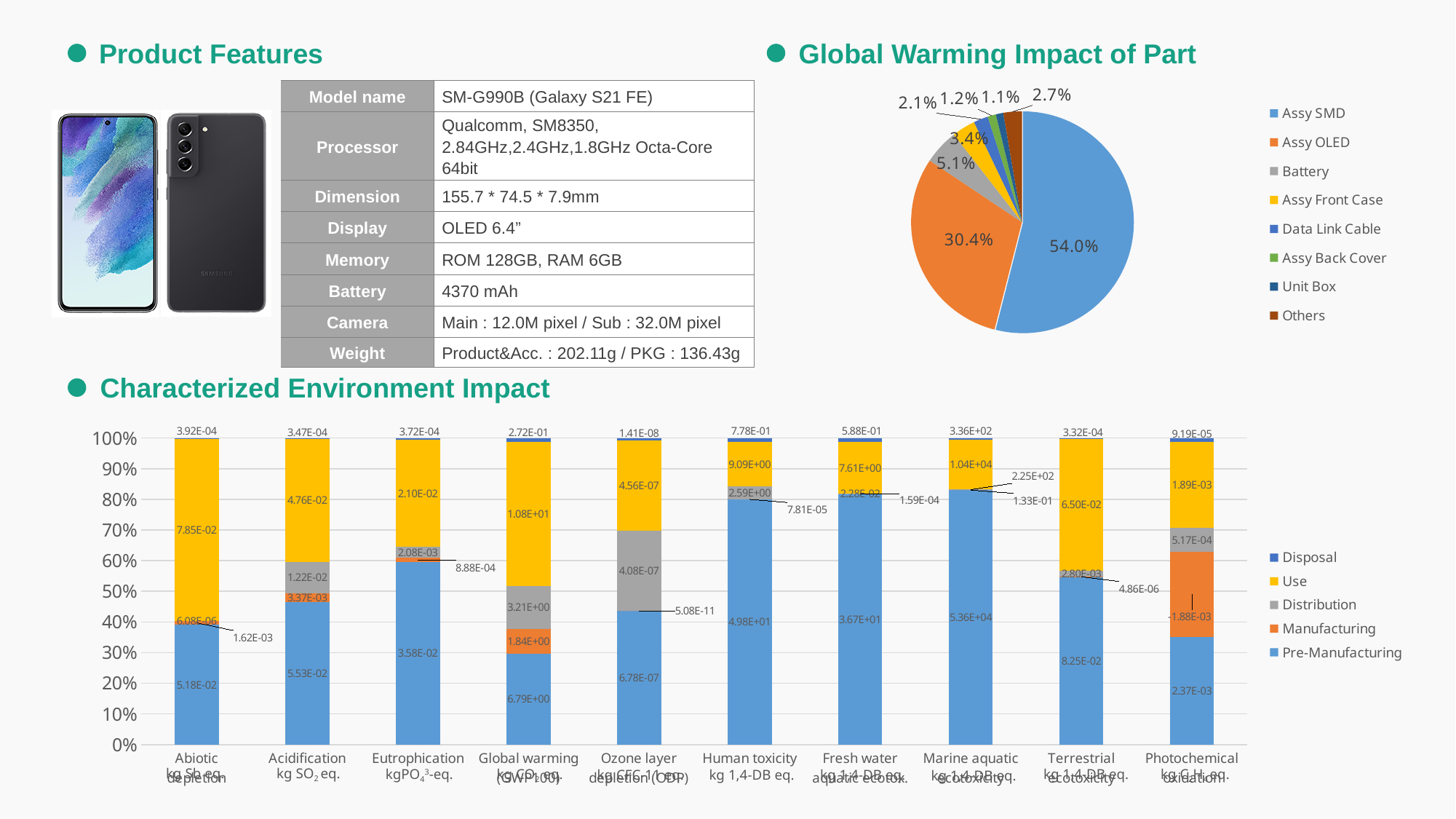
In the Global Warming Impact of Part pie chart, what share does Assy SMD have? 54.0% In the Global Warming Impact of Part pie chart, how many parts are listed in the legend? 8 In the Characterized Environment Impact chart, what is the Pre-Manufacturing value for Marine aquatic ecotoxicity? 5.36E+04 In the Global Warming Impact of Part pie chart, which part has the smallest share? Unit Box What kind of chart is the Characterized Environment Impact chart? Stacked bar chart In the Characterized Environment Impact chart, how many series does the legend list? 5 In the Characterized Environment Impact chart, what is the Use value for Global warming (GWP100)? 1.08E+01 In the Global Warming Impact of Part pie chart, which is larger, Battery or Assy Front Case? Battery In the Global Warming Impact of Part pie chart, what is the difference between the Assy SMD and Assy OLED shares? 23.6% In the Global Warming Impact of Part pie chart, what is the percentage for Assy OLED? 30.4% In the Characterized Environment Impact chart, how many impact categories are shown on the x axis? 10 In the Global Warming Impact of Part pie chart, which part has the largest share? Assy SMD